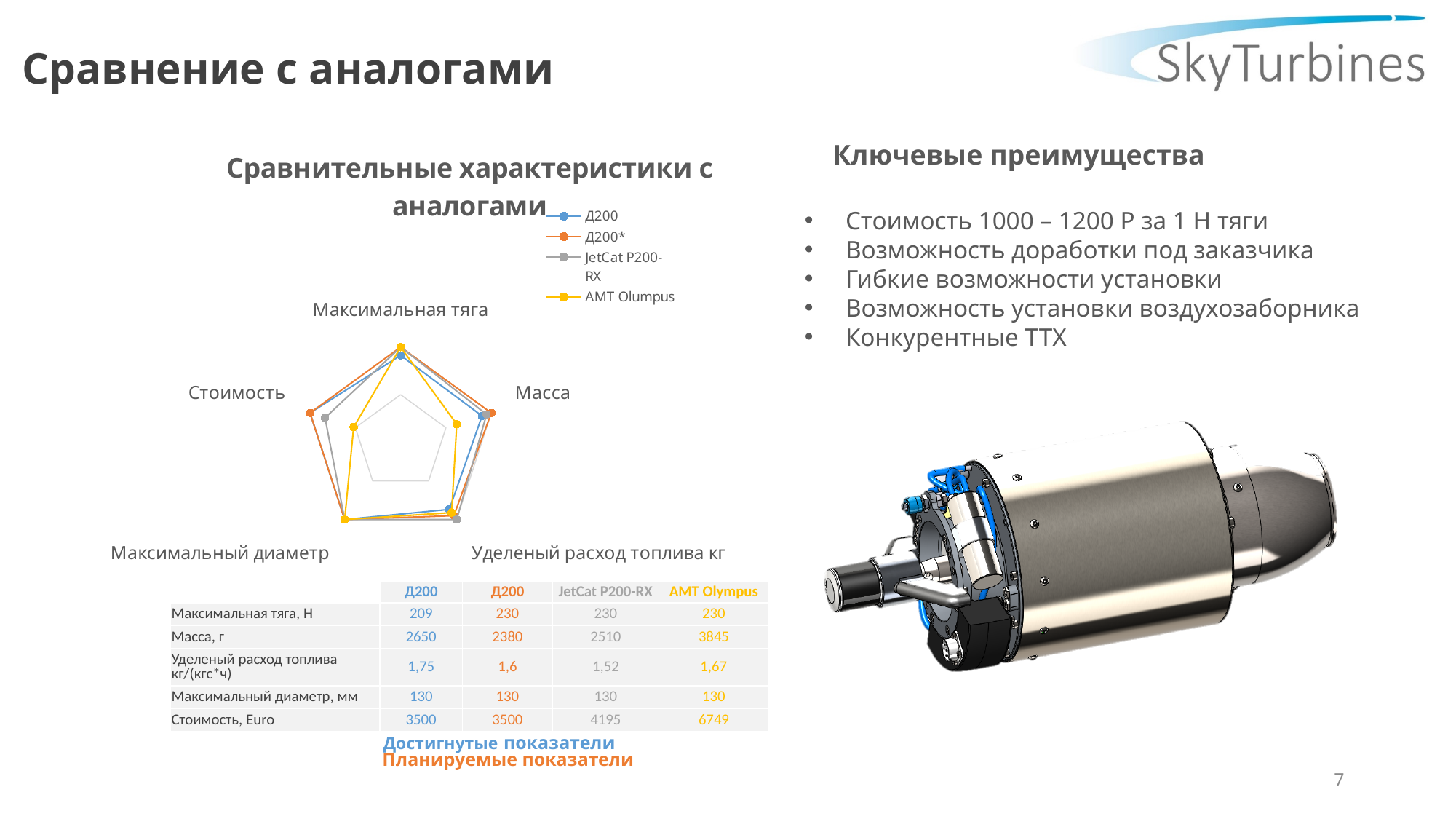
What is the difference in cost (Euro) between AMT Olumpus and Д200? 3249 According to the data table, what is the mass (Масса, г) of AMT Olumpus? 3845 According to the data table, what is the cost (Стоимость, Euro) of JetCat P200-RX? 4195 Which engine has the highest cost (Стоимость, Euro) in the table? AMT Olumpus According to the data table, what is the maximum thrust (Максимальная тяга, Н) for Д200? 209 How many axes (categories) does the radar chart have? 5 Which series is drawn in yellow on the radar chart? AMT Olumpus Which has the larger mass (Масса, г): Д200 or JetCat P200-RX? Д200 What is the maximum diameter (Максимальный диаметр, мм) for all four engines in the table? 130 Which engine has the lowest specific fuel consumption (Уделеный расход топлива) in the table? JetCat P200-RX What kind of chart is shown under the title "Сравнительные характеристики с аналогами"? Radar chart How many series does the legend of the radar chart list? 4